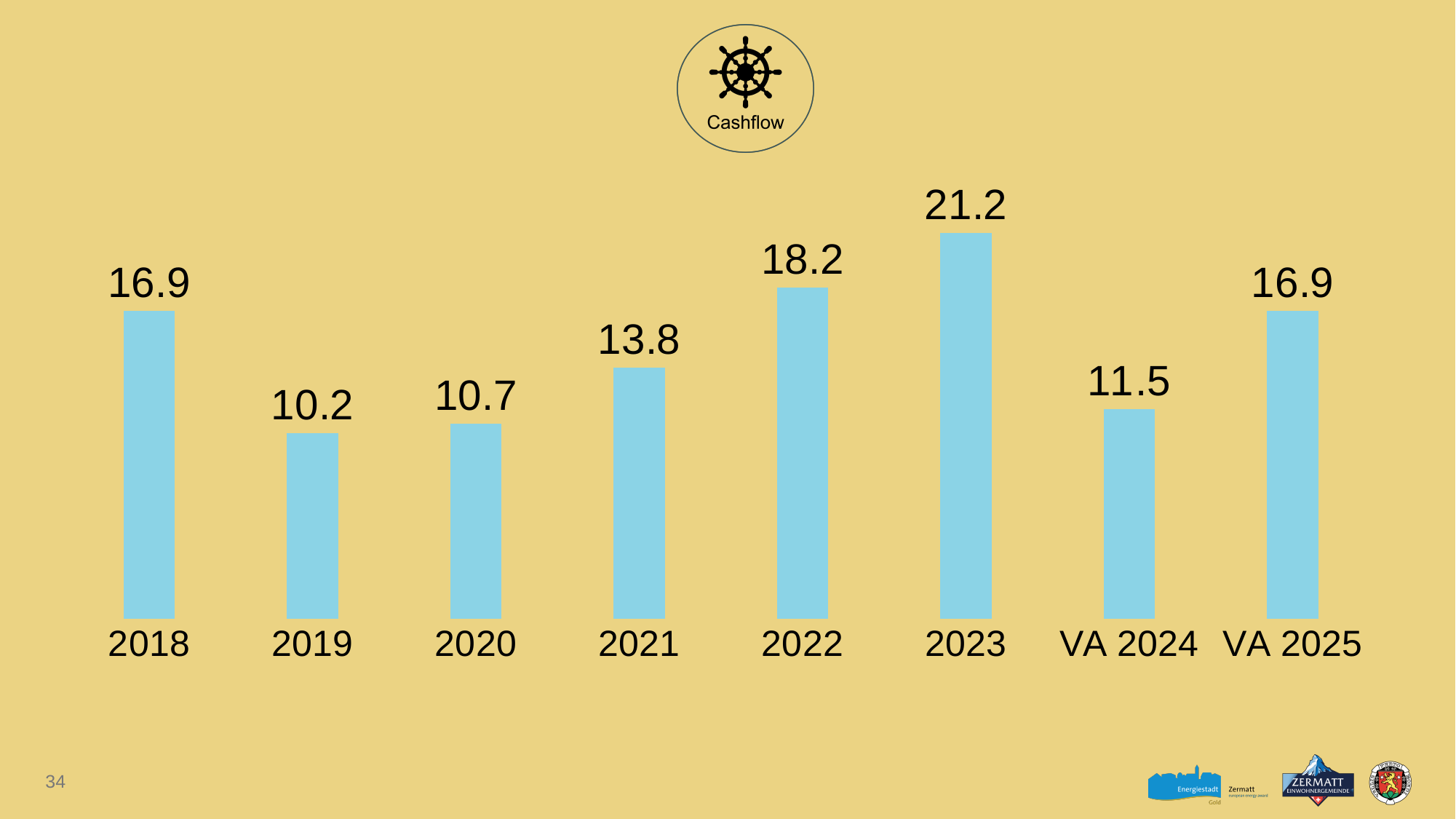
What is the cashflow value for VA 2024? 11.5 Which year has the highest cashflow? 2023 What is the difference between the cashflow in VA 2025 and in VA 2024? 5.4 What is the cashflow value for 2019? 10.2 What kind of chart is shown on the slide? Bar chart What is the difference between the cashflow in 2023 and in 2022? 3.0 How many bars are shown in the chart? 8 Which year has the lowest cashflow? 2019 What is the cashflow value for 2021? 13.8 What is the cashflow value for 2023? 21.2 Which is larger, the cashflow for 2020 or for 2021? 2021 Do the cashflow values rise or fall from 2019 to 2023? Rise